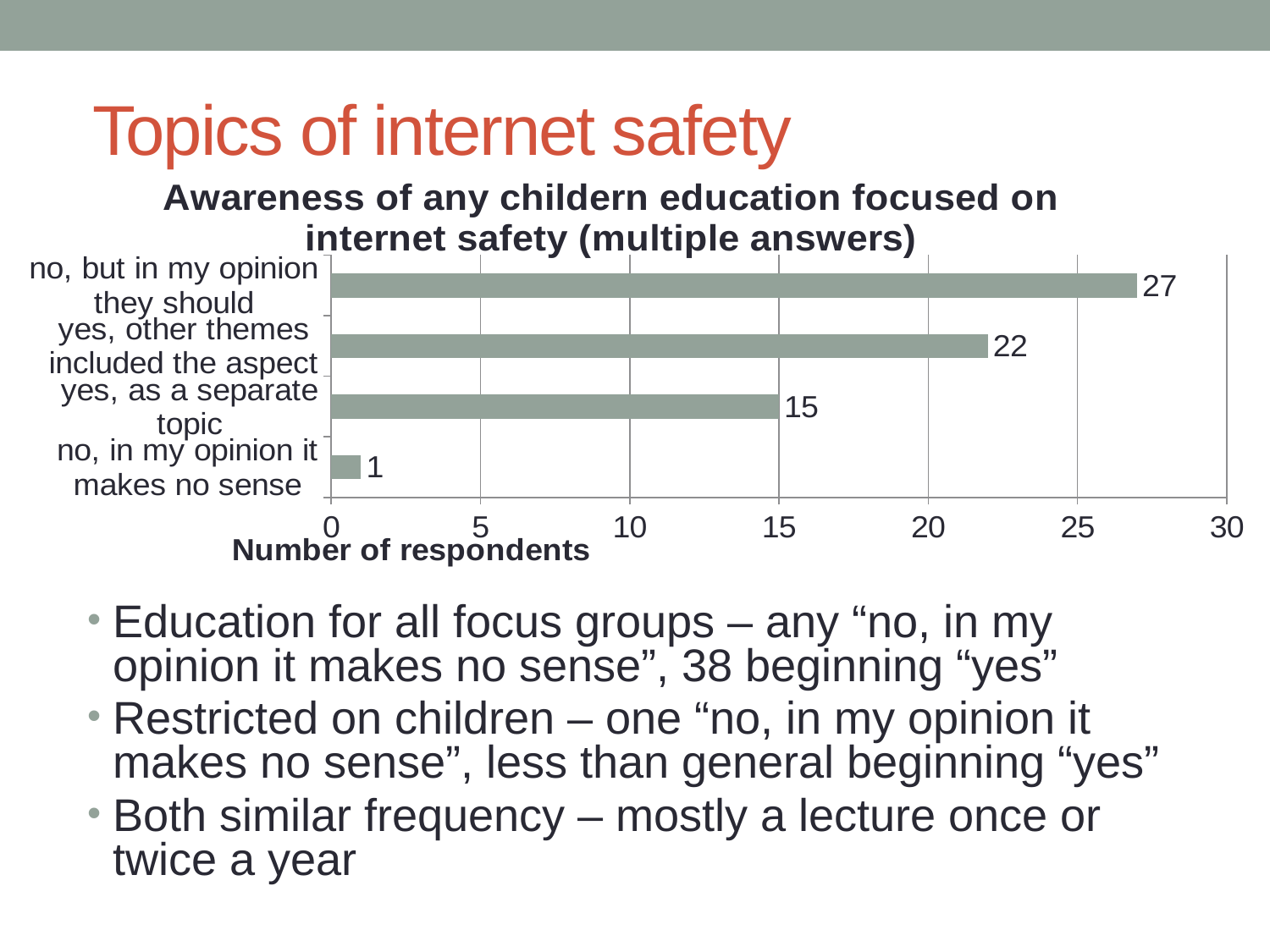
What is the difference in respondents between "no, but in my opinion they should" and "yes, other themes included the aspect"? 5 Which has more respondents: "yes, as a separate topic" or "yes, other themes included the aspect"? yes, other themes included the aspect What kind of chart is shown on the slide? bar chart What is the number of respondents for "no, but in my opinion they should"? 27 What is the difference in respondents between "yes, other themes included the aspect" and "yes, as a separate topic"? 7 Which category has the lowest number of respondents? no, in my opinion it makes no sense What is the label of the horizontal axis of the chart? Number of respondents What is the number of respondents for "yes, other themes included the aspect"? 22 What is the number of respondents for "yes, as a separate topic"? 15 What is the number of respondents for "no, in my opinion it makes no sense"? 1 Which category has the highest number of respondents? no, but in my opinion they should How many categories are shown in the chart? 4